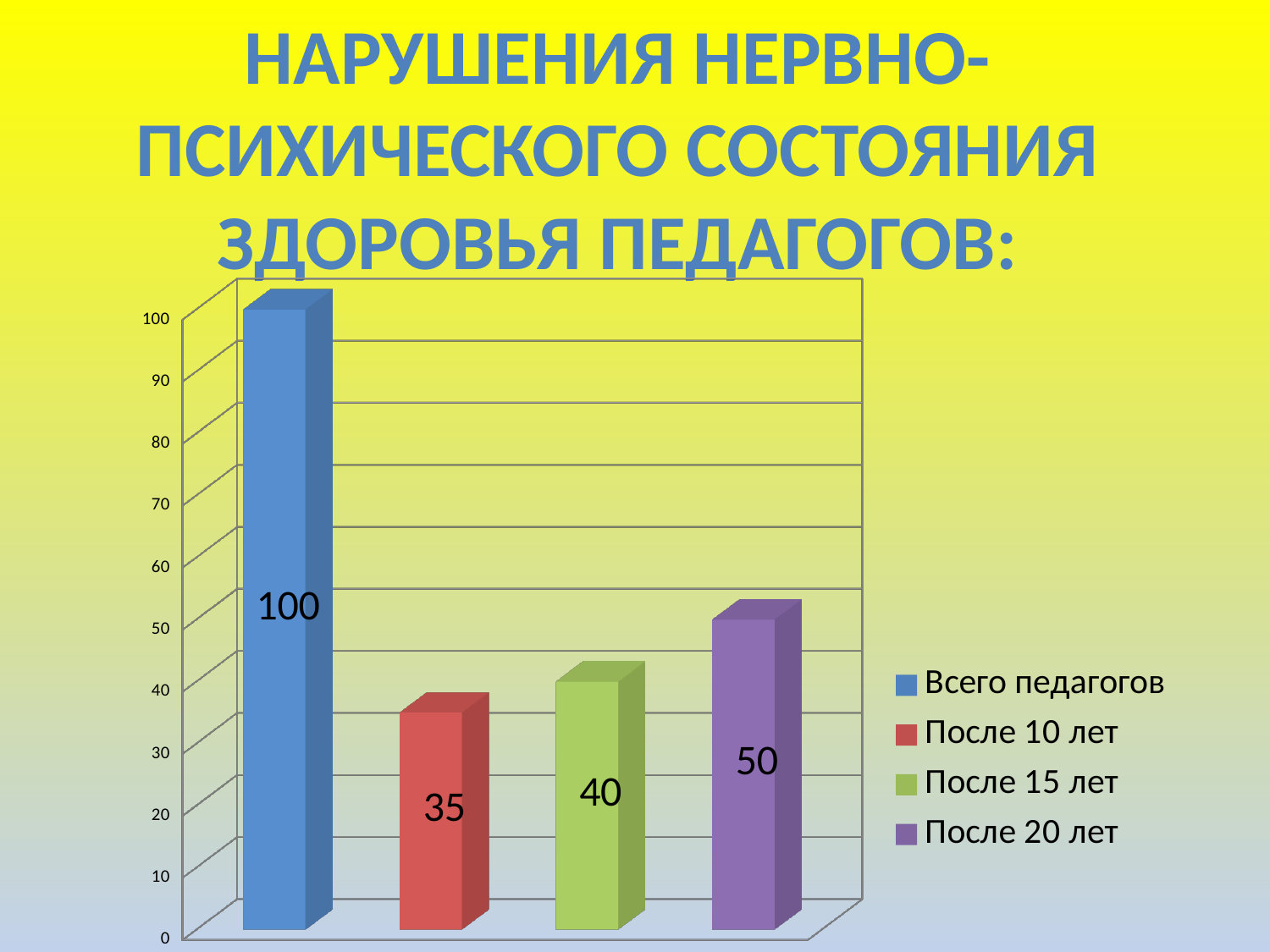
Which series has the lowest value? После 10 лет How many series does the legend list? 4 What colour is the bar for После 20 лет? purple Which series has the highest value? Всего педагогов Which is larger, the value for После 15 лет or the value for После 20 лет? После 20 лет What is the value for После 15 лет? 40 What is the value for Всего педагогов? 100 What is the difference between the values for После 20 лет and После 10 лет? 15 What kind of chart is shown on the slide? bar chart Is the value for После 10 лет greater or less than 40? less What is the value for После 10 лет? 35 What is the value for После 20 лет? 50